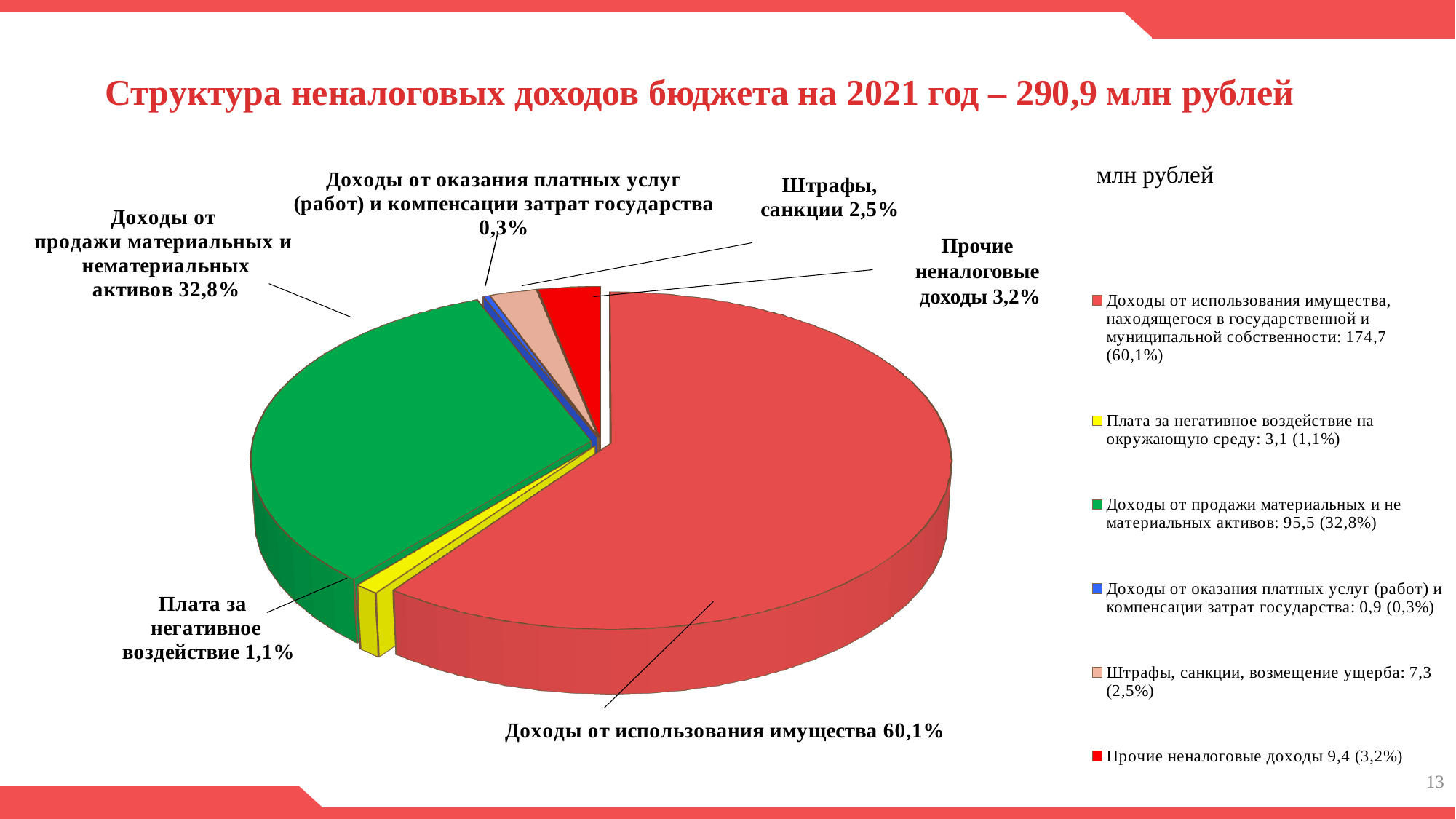
Какую долю составляют прочие неналоговые доходы? 3,2% Какой тип диаграммы показан на слайде? Круговая диаграмма На сколько млн рублей доходы от использования имущества превышают доходы от продажи материальных и нематериальных активов? 79,2 Какую долю составляют доходы от использования имущества? 60,1% Какова доля платы за негативное воздействие на окружающую среду? 1,1% Что больше: прочие неналоговые доходы или штрафы, санкции, возмещение ущерба? Прочие неналоговые доходы Какова сумма доходов от продажи материальных и нематериальных активов в млн рублей? 95,5 Каким цветом на диаграмме обозначена плата за негативное воздействие на окружающую среду? Жёлтым Какая категория имеет наибольшую долю в структуре неналоговых доходов? Доходы от использования имущества, находящегося в государственной и муниципальной собственности Сколько секторов (категорий) содержит круговая диаграмма? 6 Какая категория имеет наименьшую долю в структуре неналоговых доходов? Доходы от оказания платных услуг (работ) и компенсации затрат государства Какова сумма штрафов, санкций, возмещения ущерба в млн рублей? 7,3